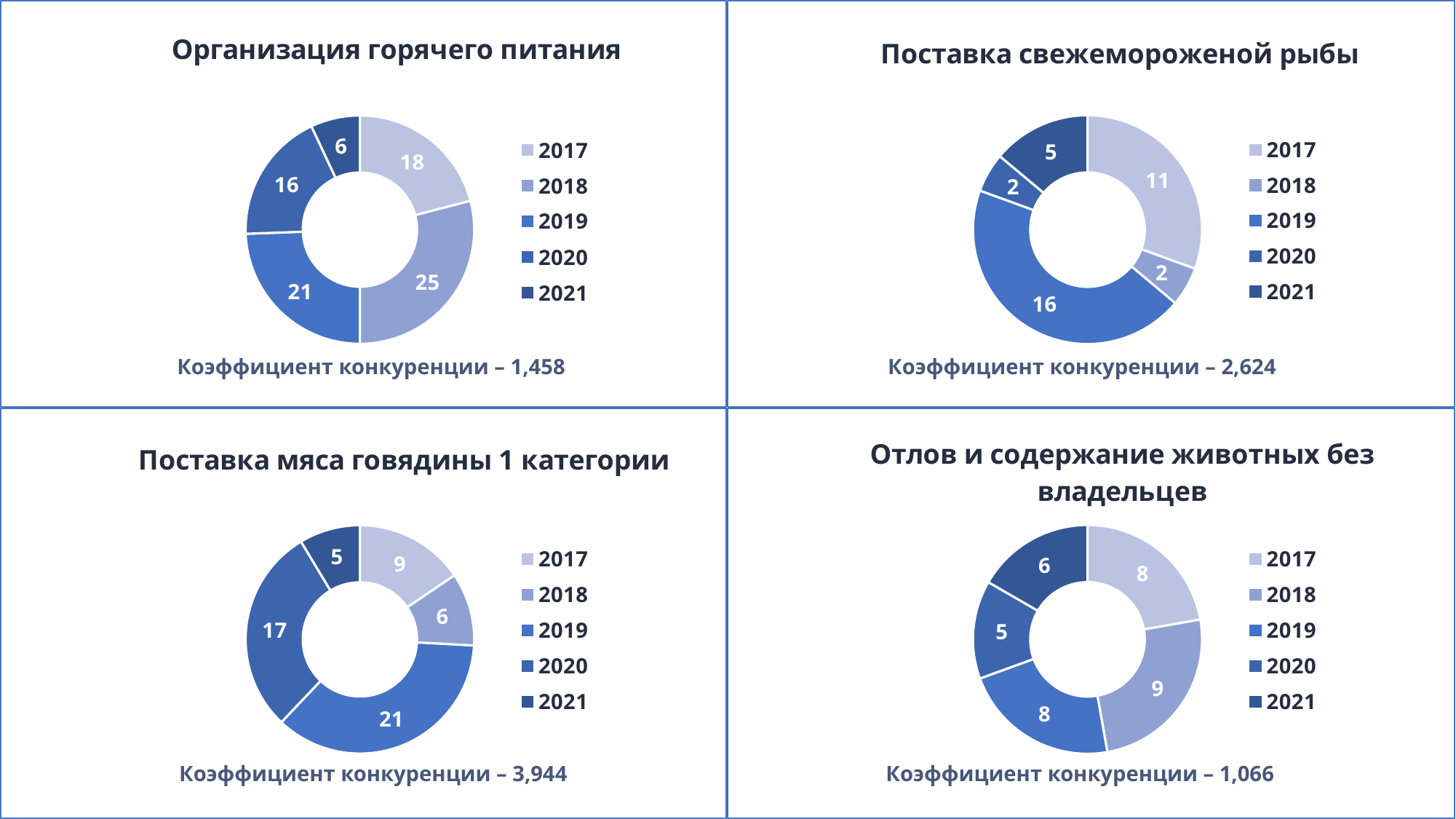
In the chart titled "Поставка свежемороженой рыбы", what is the value for 2017? 11 What competition coefficient (Коэффициент конкуренции) is shown under the chart titled "Поставка свежемороженой рыбы"? 2,624 What kind of chart is used in the chart titled "Поставка мяса говядины 1 категории"? Doughnut (pie) chart In the chart titled "Отлов и содержание животных без владельцев", which year has the highest value? 2018 How many years does the legend list in the chart titled "Организация горячего питания"? 5 In the chart titled "Организация горячего питания", which year has the lowest value? 2021 In the chart titled "Поставка свежемороженой рыбы", which year has the highest value? 2019 In the chart titled "Поставка мяса говядины 1 категории", which is larger, the value for 2017 or the value for 2018? 2017 In the chart titled "Организация горячего питания", what is the value for 2018? 25 In the chart titled "Поставка мяса говядины 1 категории", what is the difference between the values for 2019 and 2020? 4 In the chart titled "Отлов и содержание животных без владельцев", what share of the total does the 2018 slice represent? 25% In the chart titled "Отлов и содержание животных без владельцев", what is the value for 2020? 5